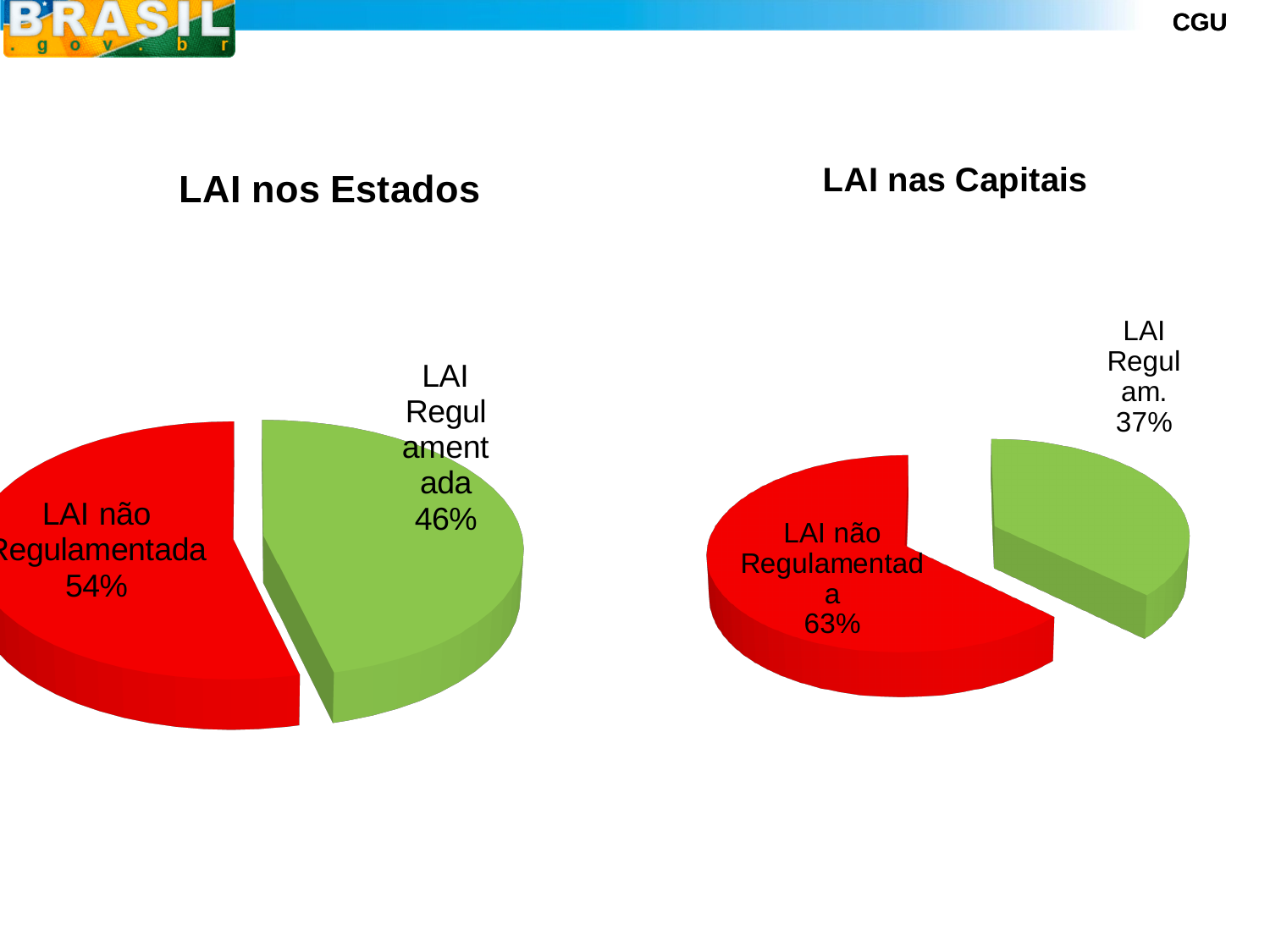
In the 'LAI nas Capitais' chart, what percentage is shown for 'LAI não Regulamentada'? 63% What type of chart is 'LAI nos Estados'? Pie chart In the 'LAI nas Capitais' chart, what is the difference between the 'LAI não Regulamentada' and 'LAI Regulam.' shares? 26% Which is larger: the 'LAI Regulamentada' share in the 'LAI nos Estados' chart or the 'LAI Regulam.' share in the 'LAI nas Capitais' chart? LAI Regulamentada in LAI nos Estados In the 'LAI nas Capitais' chart, which slice is the smallest? LAI Regulam. In the 'LAI nos Estados' chart, what percentage is shown for 'LAI Regulamentada'? 46% In the 'LAI nos Estados' chart, what colour is the 'LAI não Regulamentada' slice? Red In the 'LAI nos Estados' chart, what percentage is shown for 'LAI não Regulamentada'? 54% In the 'LAI nos Estados' chart, which slice is the largest? LAI não Regulamentada How many slices does the 'LAI nas Capitais' chart have? 2 In the 'LAI nos Estados' chart, what is the difference between the 'LAI não Regulamentada' and 'LAI Regulamentada' shares? 8% In the 'LAI nas Capitais' chart, what percentage is shown for 'LAI Regulam.'? 37%